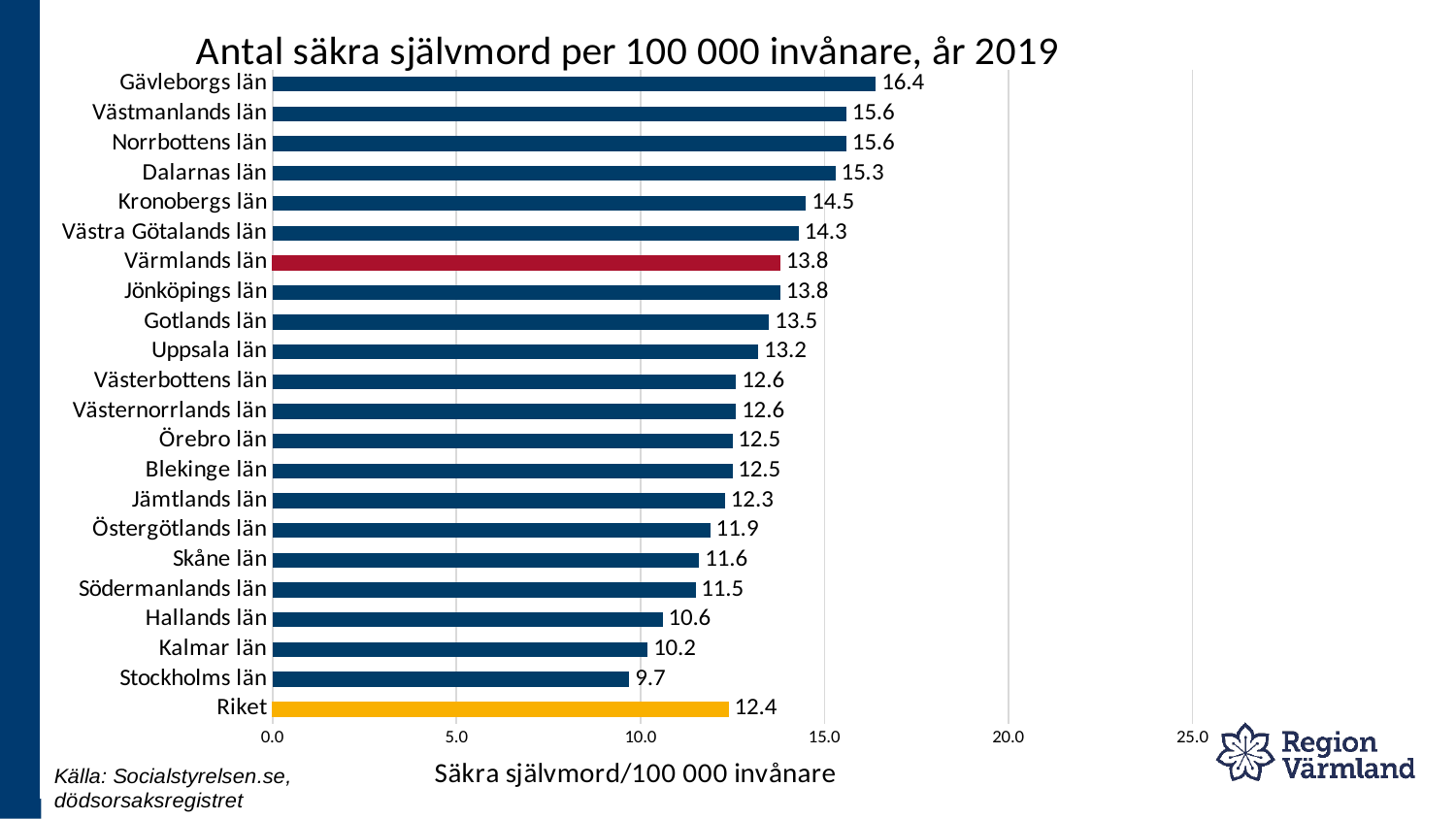
Which category has the lowest value? Stockholms län Which is larger, the value for Dalarnas län or the value for Kronobergs län? Dalarnas län How many bars are shown in the chart? 22 What is the value for Riket? 12.4 What is the difference between the values for Värmlands län and Riket? 1.4 What is the value for Värmlands län? 13.8 What is the title of the chart? Antal säkra självmord per 100 000 invånare, år 2019 Is the value for Hallands län greater or less than 15.0? less Which category has the highest value? Gävleborgs län What is the value for Stockholms län? 9.7 What is the difference between the values for Gävleborgs län and Stockholms län? 6.7 What kind of chart is shown on the slide? bar chart